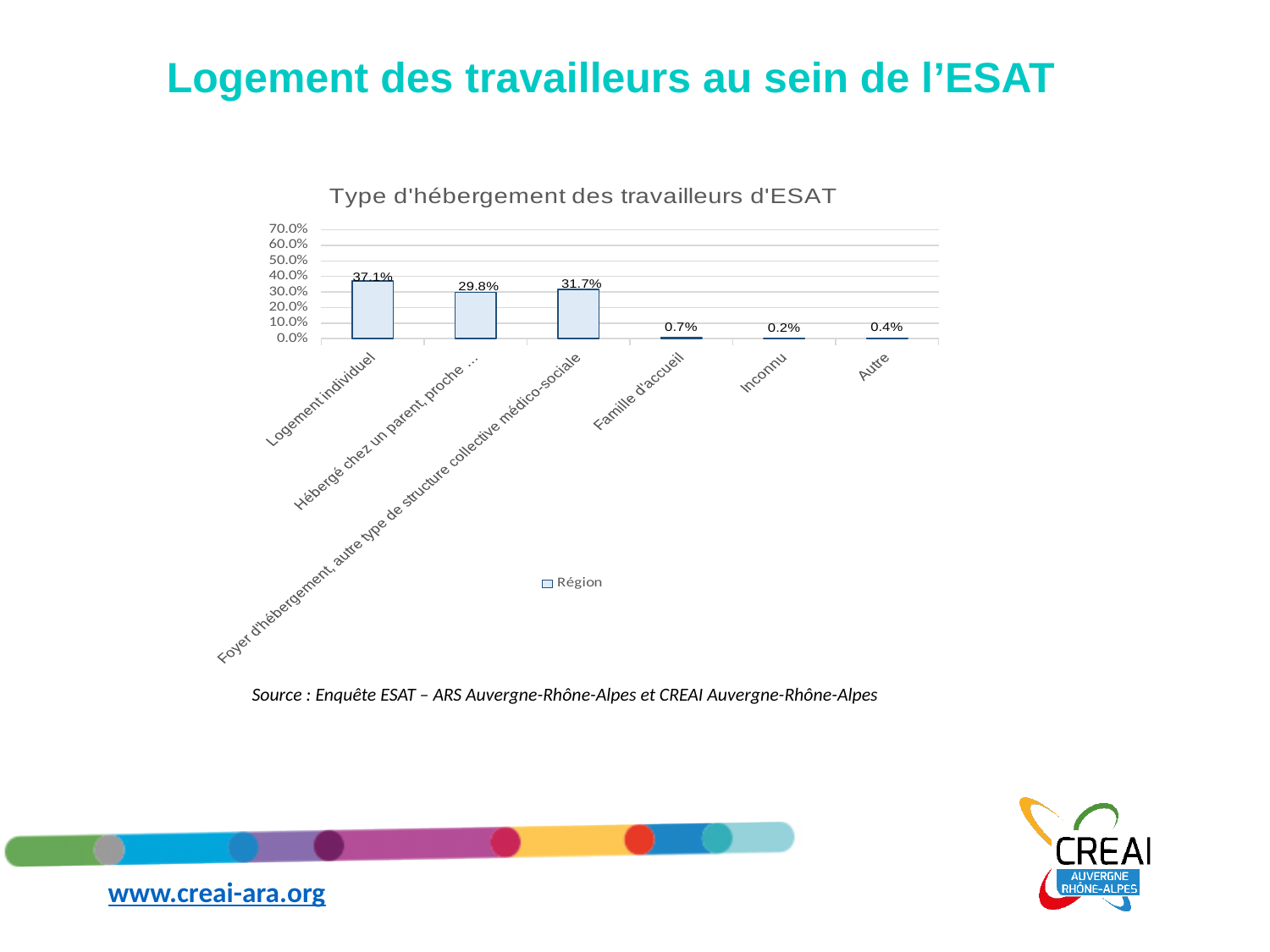
Is the value for Logement individuel greater or less than 30.0%? greater What is the value for Famille d'accueil? 0.7% What is the difference between the values for Logement individuel and Famille d'accueil? 36.4% Which is larger, the value for Foyer d'hébergement, autre type de structure collective médico-sociale or the value for Hébergé chez un parent, proche? Foyer d'hébergement, autre type de structure collective médico-sociale What kind of chart is shown on the slide? bar chart What is the value for Autre? 0.4% What is the value for Logement individuel? 37.1% What series name is listed in the legend? Région Which category has the lowest value? Inconnu What is the value for Inconnu? 0.2% How many categories are shown on the x axis? 6 Which category has the highest value? Logement individuel